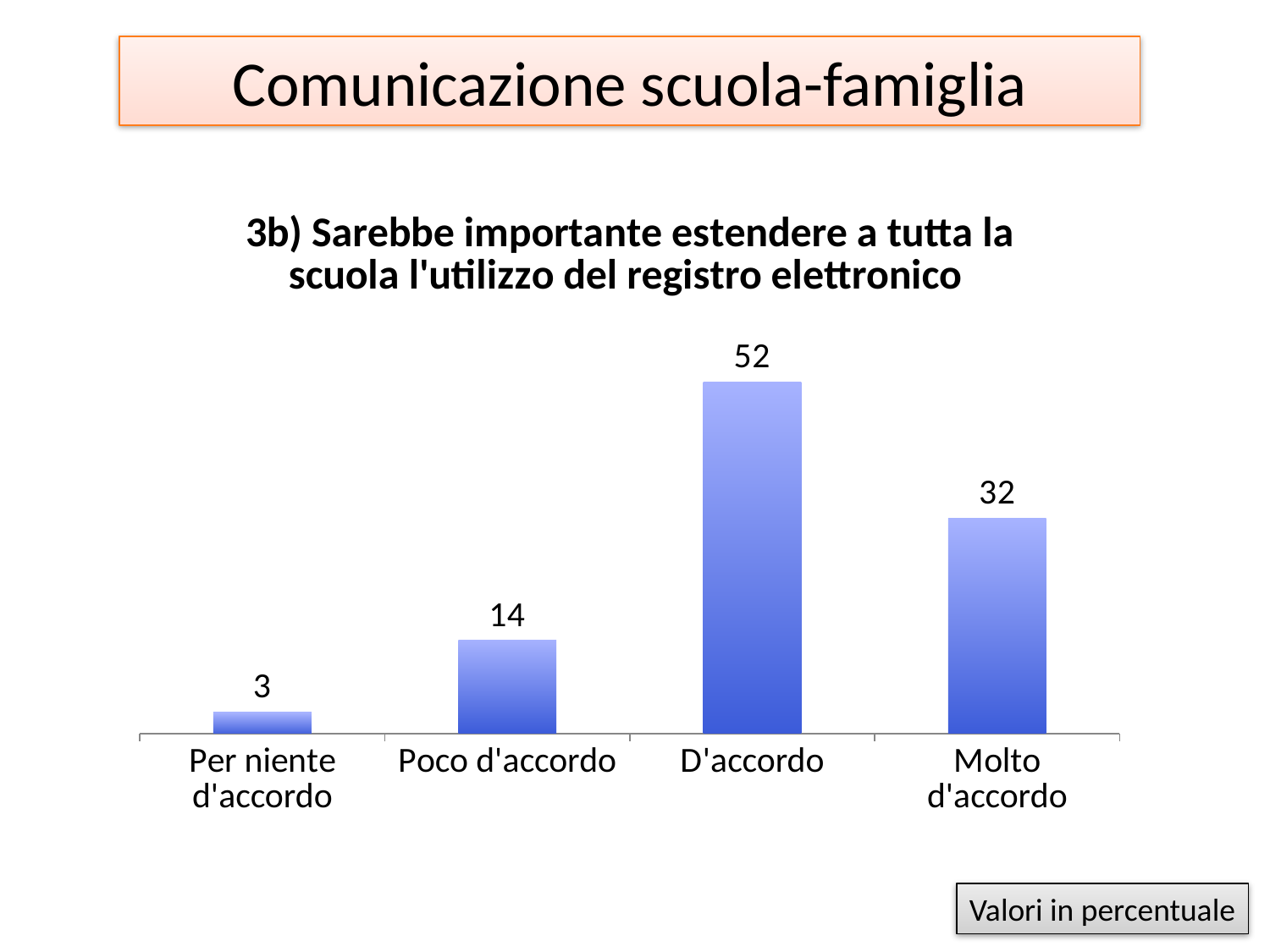
Which category has the highest value? D'accordo Which is larger, the value for "Molto d'accordo" or the value for "Poco d'accordo"? Molto d'accordo What kind of chart is shown on the slide? Bar chart Which category has the lowest value? Per niente d'accordo How many categories are shown on the x axis? 4 What is the value for "Per niente d'accordo"? 3 What is the value for "Molto d'accordo"? 32 What is the value for "Poco d'accordo"? 14 What is the title of the chart? 3b) Sarebbe importante estendere a tutta la scuola l'utilizzo del registro elettronico What is the difference between the values for "D'accordo" and "Molto d'accordo"? 20 What is the difference between the values for "Poco d'accordo" and "Per niente d'accordo"? 11 What is the value for "D'accordo"? 52